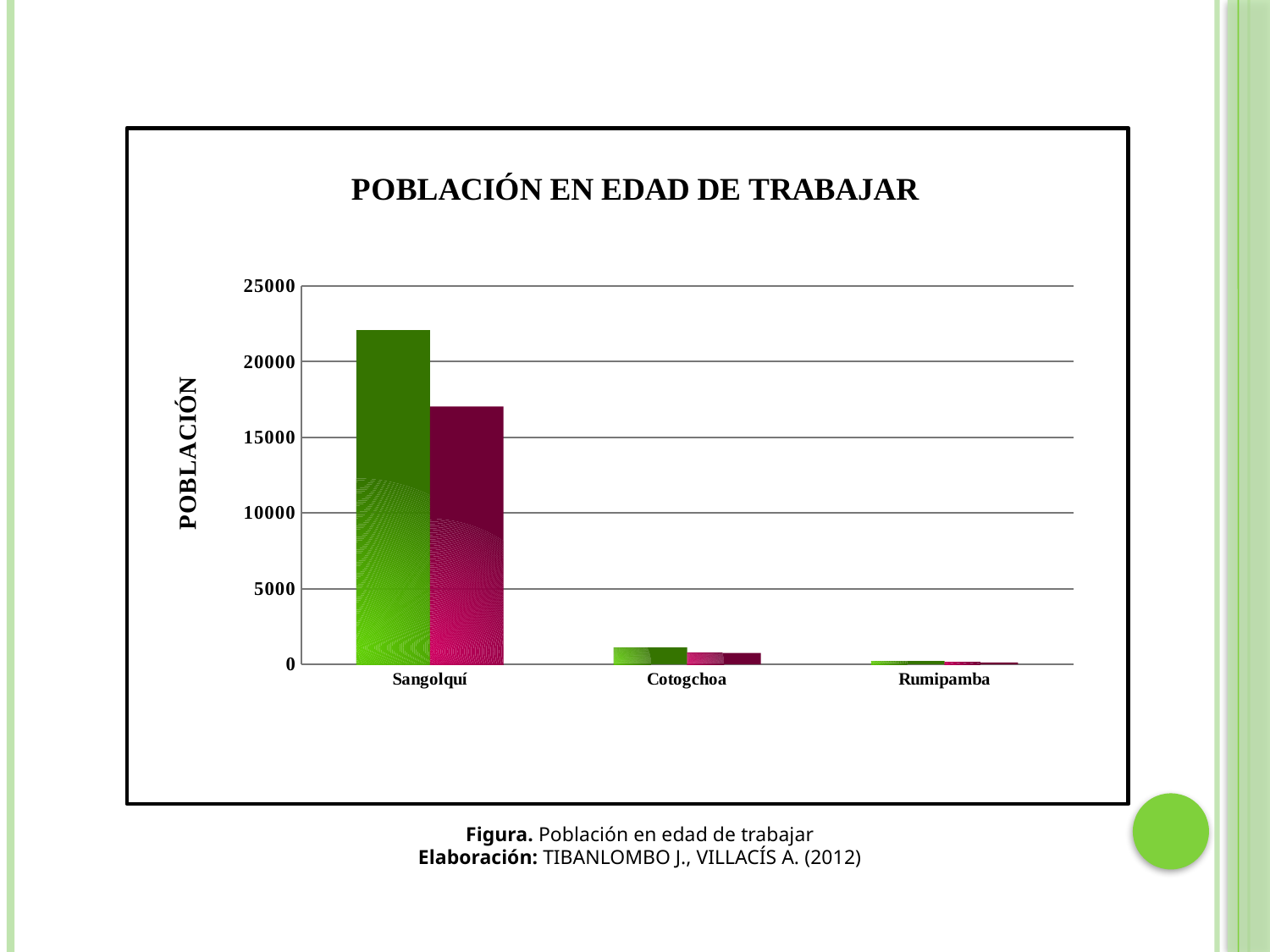
Is the value of the magenta bar for Sangolquí greater or less than 15000? greater What is the label on the vertical axis of the chart? POBLACIÓN Is the value of the green bar for Cotogchoa greater or less than 5000? less For Sangolquí, which bar is larger, the green bar or the magenta bar? The green bar What kind of chart is shown on the slide? Bar chart Is the value of the green bar for Sangolquí greater or less than 20000? greater Which category has the highest values in the chart? Sangolquí What is the title of the chart? POBLACIÓN EN EDAD DE TRABAJAR How many bars are plotted for each category in the chart? 2 How many categories are shown on the x axis of the chart? 3 Which category has the lowest values in the chart? Rumipamba